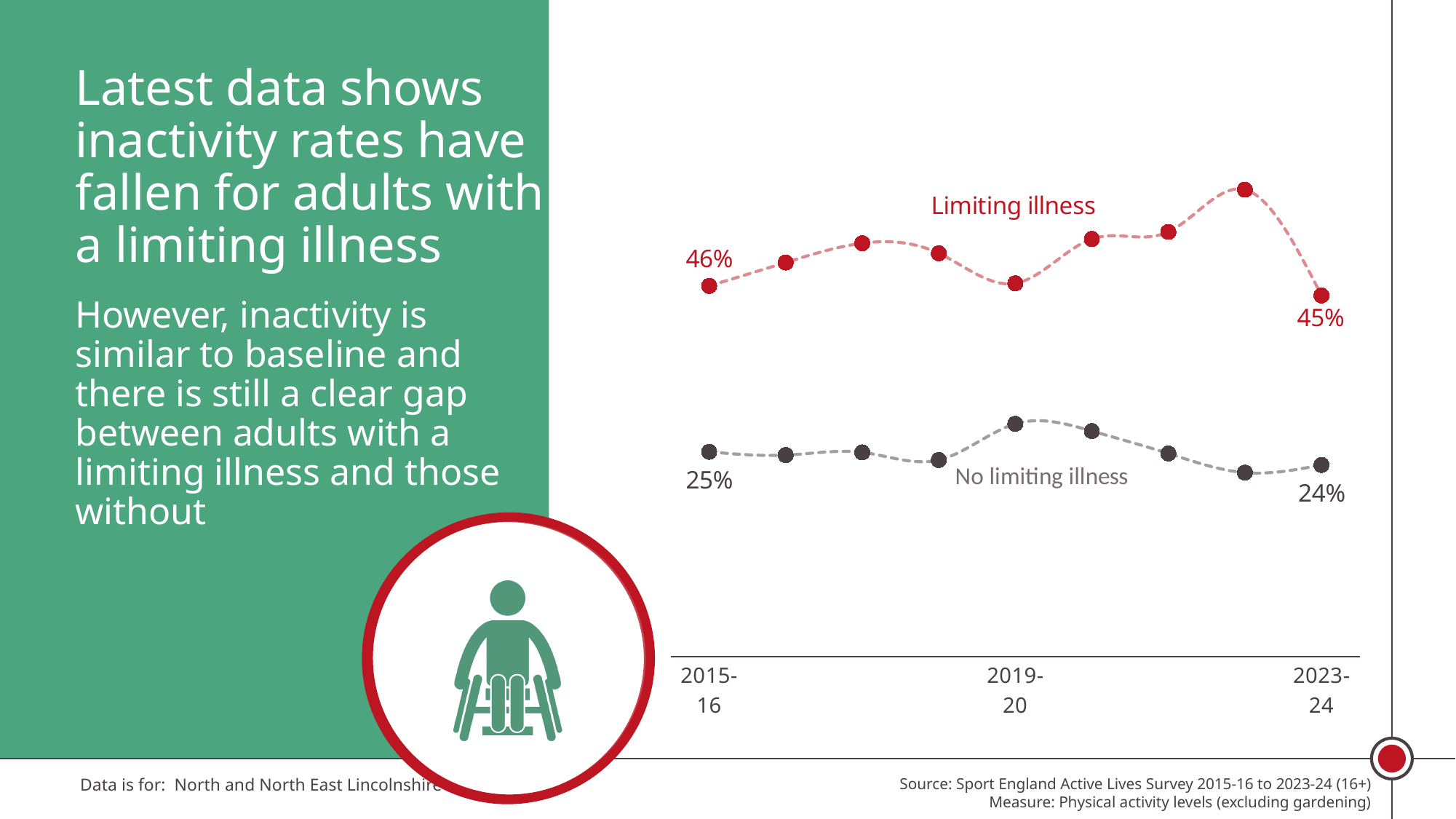
How many series are plotted on the chart? 2 Which series has the higher value in 2023-24, Limiting illness or No limiting illness? Limiting illness How many data points does each series have? 9 What is the gap between the limiting illness and no limiting illness rates in 2023-24? 21 percentage points What is the inactivity rate for adults with no limiting illness in 2023-24? 24% What is the inactivity rate for adults with no limiting illness in 2015-16? 25% By how much did the limiting illness inactivity rate change from 2015-16 to 2023-24? 1 percentage point Did the inactivity rate for adults with a limiting illness rise or fall between 2015-16 and 2023-24? Fall What is the inactivity rate for adults with a limiting illness in 2023-24? 45% What is the inactivity rate for adults with a limiting illness in 2015-16? 46% What is the gap between the limiting illness and no limiting illness rates in 2015-16? 21 percentage points What kind of chart is shown on the slide? Line chart